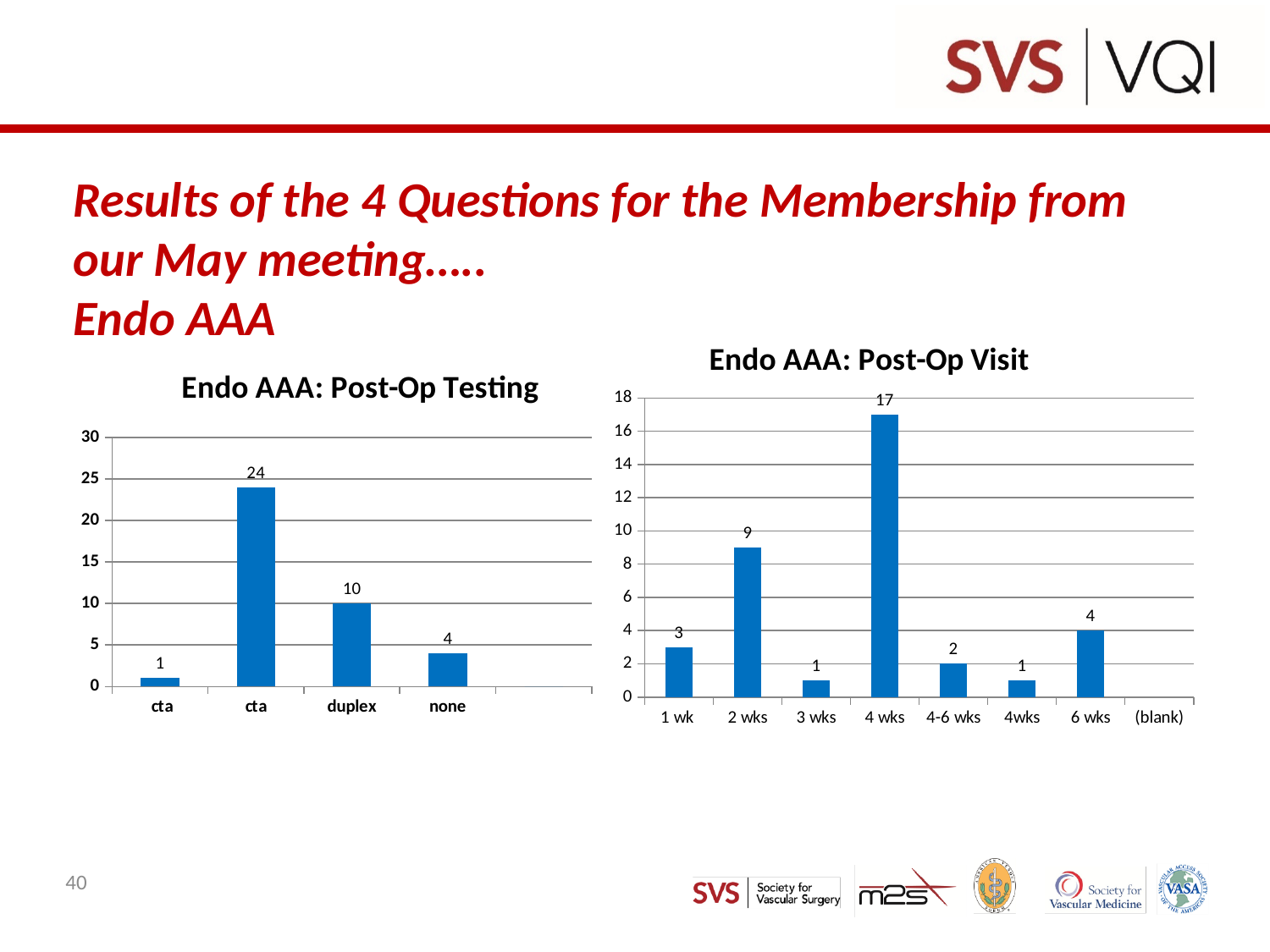
In the "Endo AAA: Post-Op Visit" chart, which is larger, the value for 1 wk or the value for 4-6 wks? 1 wk In the "Endo AAA: Post-Op Visit" chart, what is the value for 4 wks? 17 In the "Endo AAA: Post-Op Testing" chart, what kind of chart is shown? bar chart In the "Endo AAA: Post-Op Testing" chart, what is the value for duplex? 10 In the "Endo AAA: Post-Op Testing" chart, what is the value for none? 4 In the "Endo AAA: Post-Op Testing" chart, what is the difference between the duplex value and the none value? 6 In the "Endo AAA: Post-Op Visit" chart, what is the value for 6 wks? 4 In the "Endo AAA: Post-Op Visit" chart, which category has the highest value? 4 wks In the "Endo AAA: Post-Op Visit" chart, how many categories are labelled on the x axis? 8 In the "Endo AAA: Post-Op Visit" chart, what is the difference between the 4 wks value and the 2 wks value? 8 In the "Endo AAA: Post-Op Testing" chart, what is the value of the tallest bar? 24 In the "Endo AAA: Post-Op Visit" chart, what is the value for 2 wks? 9